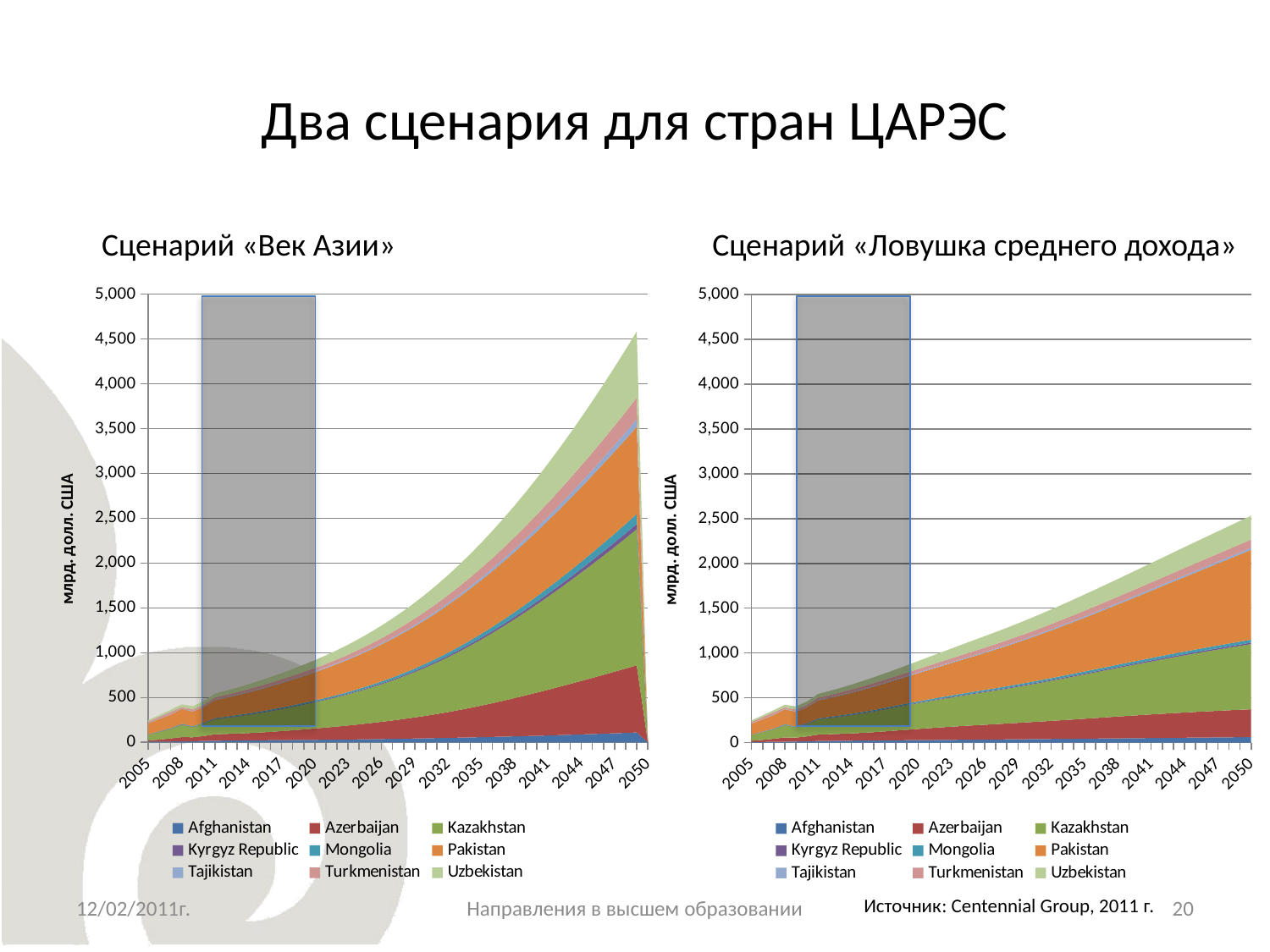
How many series does the legend of the 'Сценарий «Ловушка среднего дохода»' chart list? 9 In the 'Сценарий «Век Азии»' chart, is the total stacked value in 2047 greater or less than 3,000? greater In the 'Сценарий «Век Азии»' chart, do the total values generally rise or fall from 2005 to 2047? rise In the 'Сценарий «Ловушка среднего дохода»' chart, is the total stacked value in 2050 greater or less than 2,000? greater What kind of chart is the 'Сценарий «Век Азии»' chart? stacked area chart How many year labels are shown on the x axis of the 'Сценарий «Век Азии»' chart? 16 How many series does the legend of the 'Сценарий «Век Азии»' chart list? 9 Which chart shows a higher total stacked value in 2047: 'Сценарий «Век Азии»' or 'Сценарий «Ловушка среднего дохода»'? Сценарий «Век Азии» In the 'Сценарий «Ловушка среднего дохода»' chart, is the total stacked value in 2050 greater or less than 3,000? less In the 'Сценарий «Ловушка среднего дохода»' chart, do the total values rise or fall from 2005 to 2050? rise Which series is shown in orange in the legend of the 'Сценарий «Век Азии»' chart? Pakistan What is the y-axis title of the 'Сценарий «Ловушка среднего дохода»' chart? млрд. долл. США